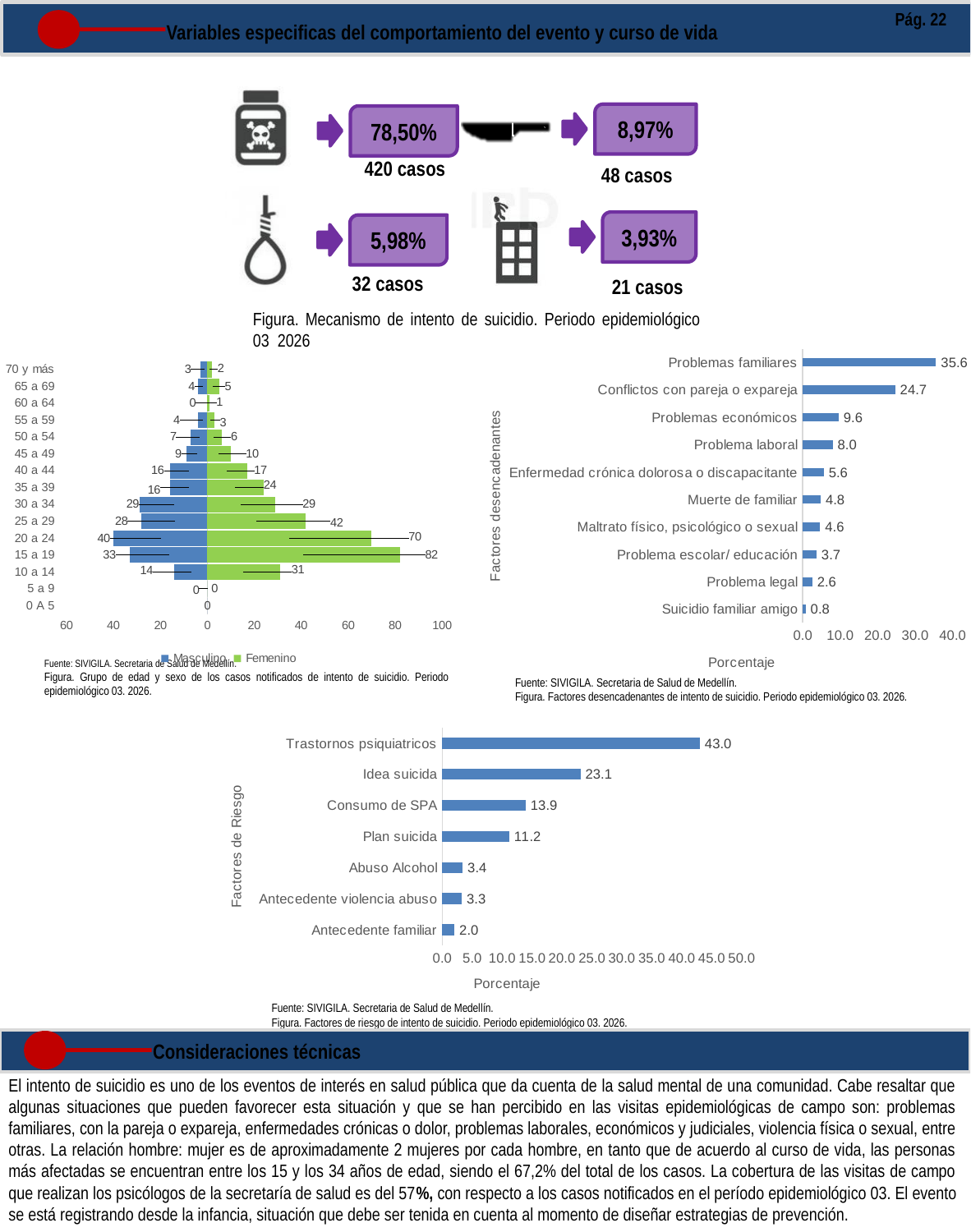
In the 'Factores desencadenantes' chart, what is the percentage for Problemas familiares? 35.6 How many factors are listed in the 'Factores desencadenantes' chart? 10 In the 'Factores de Riesgo' chart, which is larger: Consumo de SPA or Plan suicida? Consumo de SPA In the 'Factores desencadenantes' chart, what is the difference between Problemas familiares and Conflictos con pareja o expareja? 10.9 In the age group and sex chart (Grupo de edad y sexo), what is the Masculino value for the 20 a 24 age group? 40 How many factors are listed in the 'Factores de Riesgo' chart? 7 What type of chart is the 'Factores de Riesgo' chart? Bar chart In the 'Factores desencadenantes' chart, which factor has the lowest percentage? Suicidio familiar amigo How many series does the legend of the age group and sex chart (Grupo de edad y sexo) list? 2 In the 'Factores de Riesgo' chart, which factor has the highest percentage? Trastornos psiquiatricos In the 'Factores de Riesgo' chart, what is the percentage for Idea suicida? 23.1 In the age group and sex chart (Grupo de edad y sexo), what is the Femenino value for the 15 a 19 age group? 82